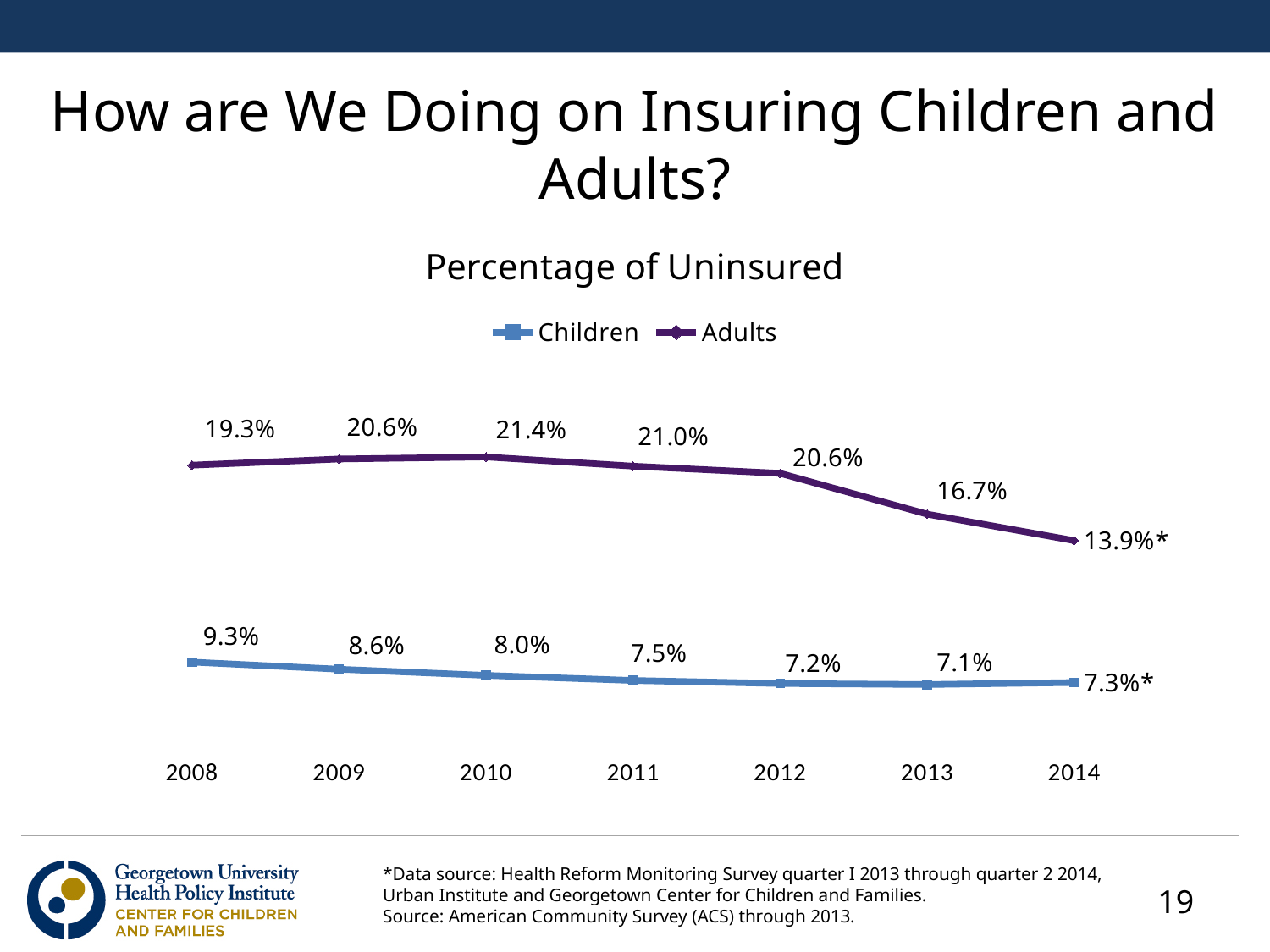
What kind of chart is shown on the slide? Line chart In which year is the percentage of uninsured children lowest? 2013 What is the difference between the adult and children uninsured percentages in 2012? 13.4% What is the percentage of uninsured adults in 2010? 21.4% How many years are shown on the x axis? 7 What is the percentage of uninsured adults in 2014? 13.9% How many series does the legend list? 2 In which year is the percentage of uninsured adults highest? 2010 What is the title of the chart? Percentage of Uninsured What is the percentage of uninsured children in 2008? 9.3% Does the percentage of uninsured adults rise or fall from 2010 to 2014? Fall Which is larger, the uninsured percentage for children in 2009 or in 2013? 2009